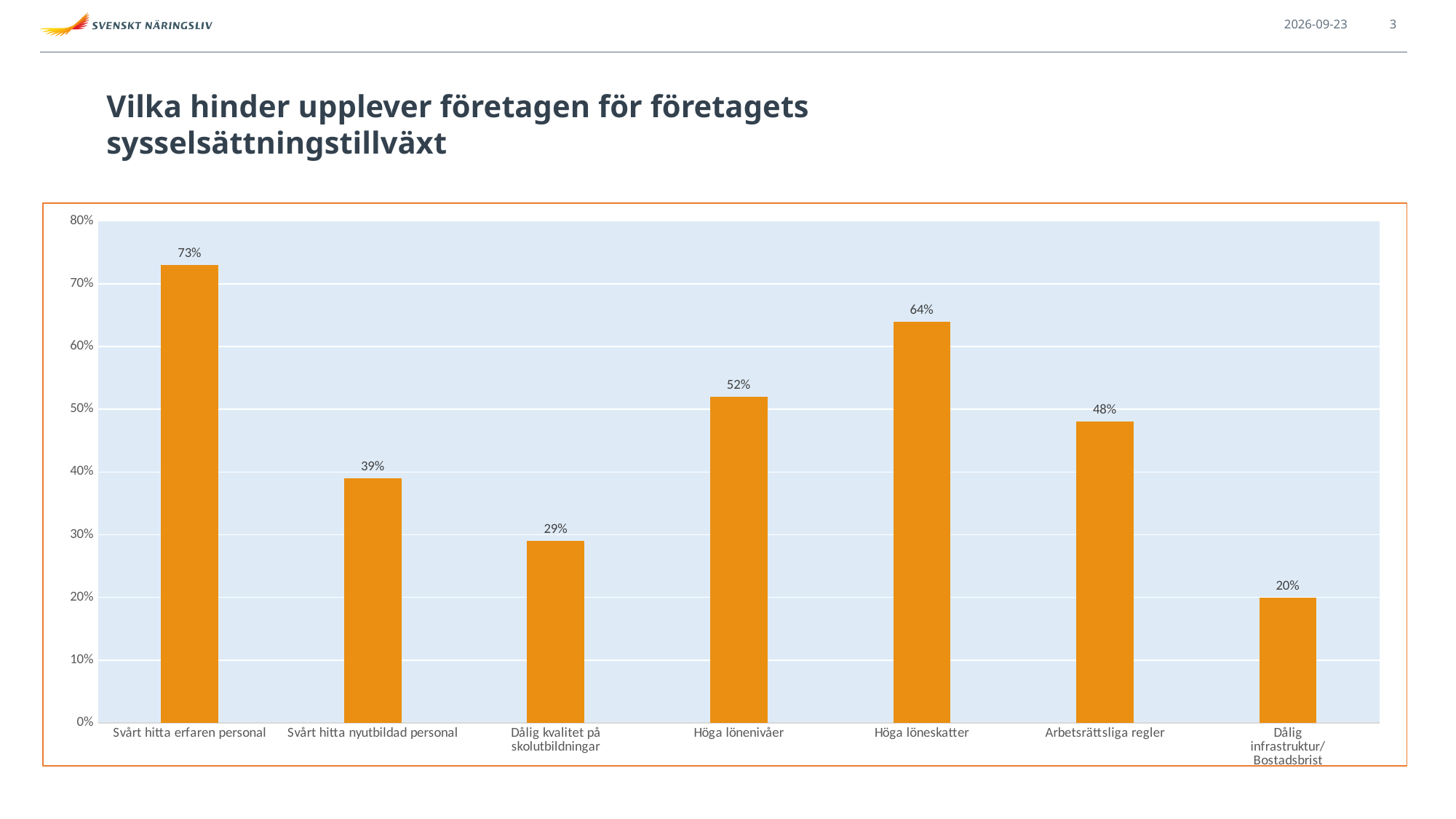
Is the value for Dålig kvalitet på skolutbildningar greater or less than 30%? less Which category has the lowest value? Dålig infrastruktur/Bostadsbrist What is the value for Höga löneskatter? 64% What is the value for Svårt hitta erfaren personal? 73% What kind of chart is shown on the slide? Bar chart What is the difference between Svårt hitta erfaren personal and Svårt hitta nyutbildad personal? 34 percentage points Which category has the highest value? Svårt hitta erfaren personal Which is larger, Höga lönenivåer or Höga löneskatter? Höga löneskatter What is the value for Dålig infrastruktur/Bostadsbrist? 20% What colour are the bars in the chart? Orange What is the value for Arbetsrättsliga regler? 48% How many categories are shown in the chart? 7